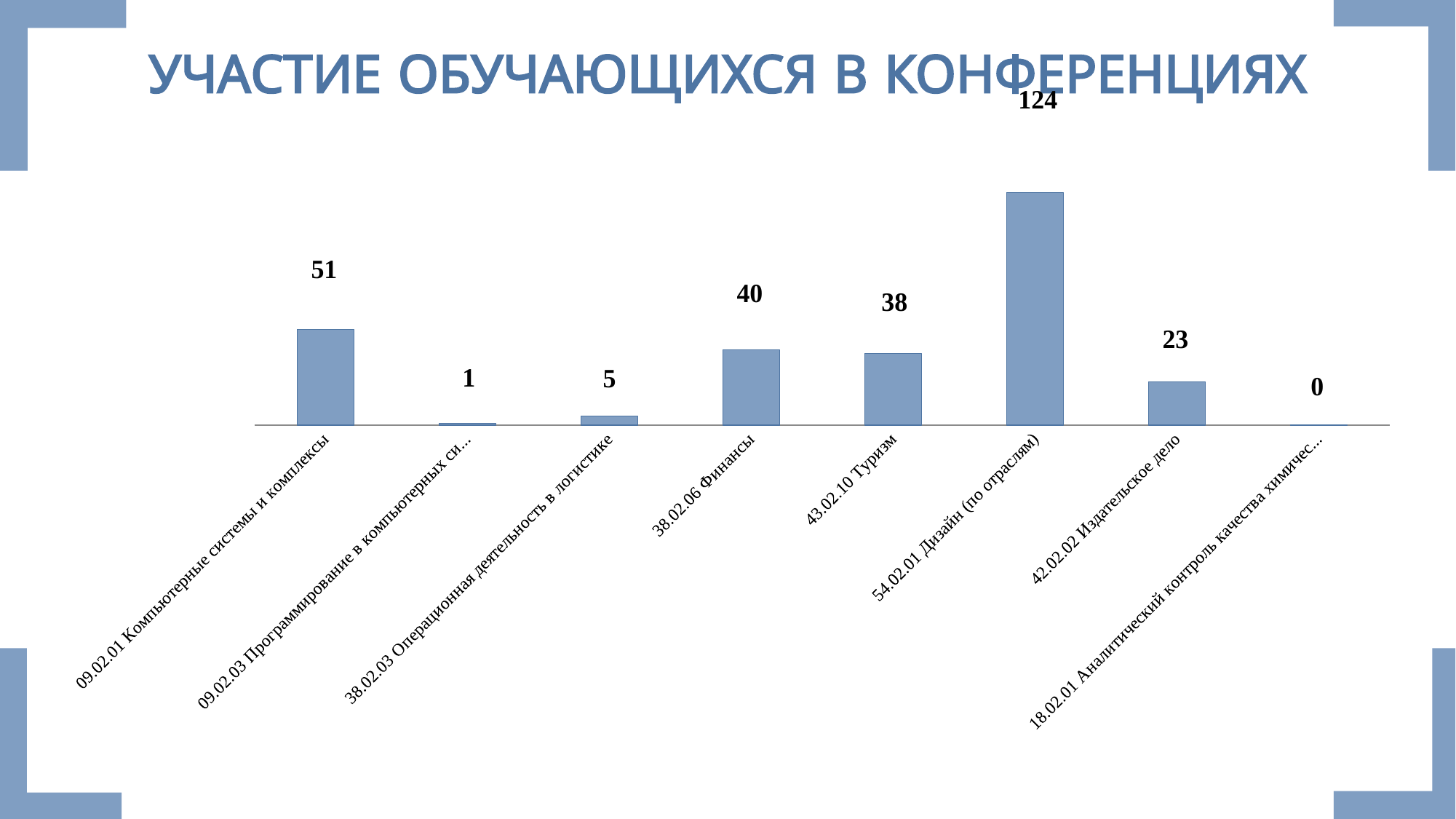
Which category has the highest value? 54.02.01 Дизайн (по отраслям) What is the value for 09.02.01 Компьютерные системы и комплексы? 51 What is the value for 38.02.06 Финансы? 40 What is the value for 54.02.01 Дизайн (по отраслям)? 124 What is the value for 43.02.10 Туризм? 38 What is the title of the slide? УЧАСТИЕ ОБУЧАЮЩИХСЯ В КОНФЕРЕНЦИЯХ How many categories are shown on the chart? 8 What is the difference between the values for 54.02.01 Дизайн (по отраслям) and 09.02.01 Компьютерные системы и комплексы? 73 What is the value for 42.02.02 Издательское дело? 23 What is the difference between the values for 38.02.03 Операционная деятельность в логистике and 42.02.02 Издательское дело? 18 Which is larger, the value for 38.02.06 Финансы or the value for 43.02.10 Туризм? 38.02.06 Финансы What kind of chart is shown on the slide? Bar chart